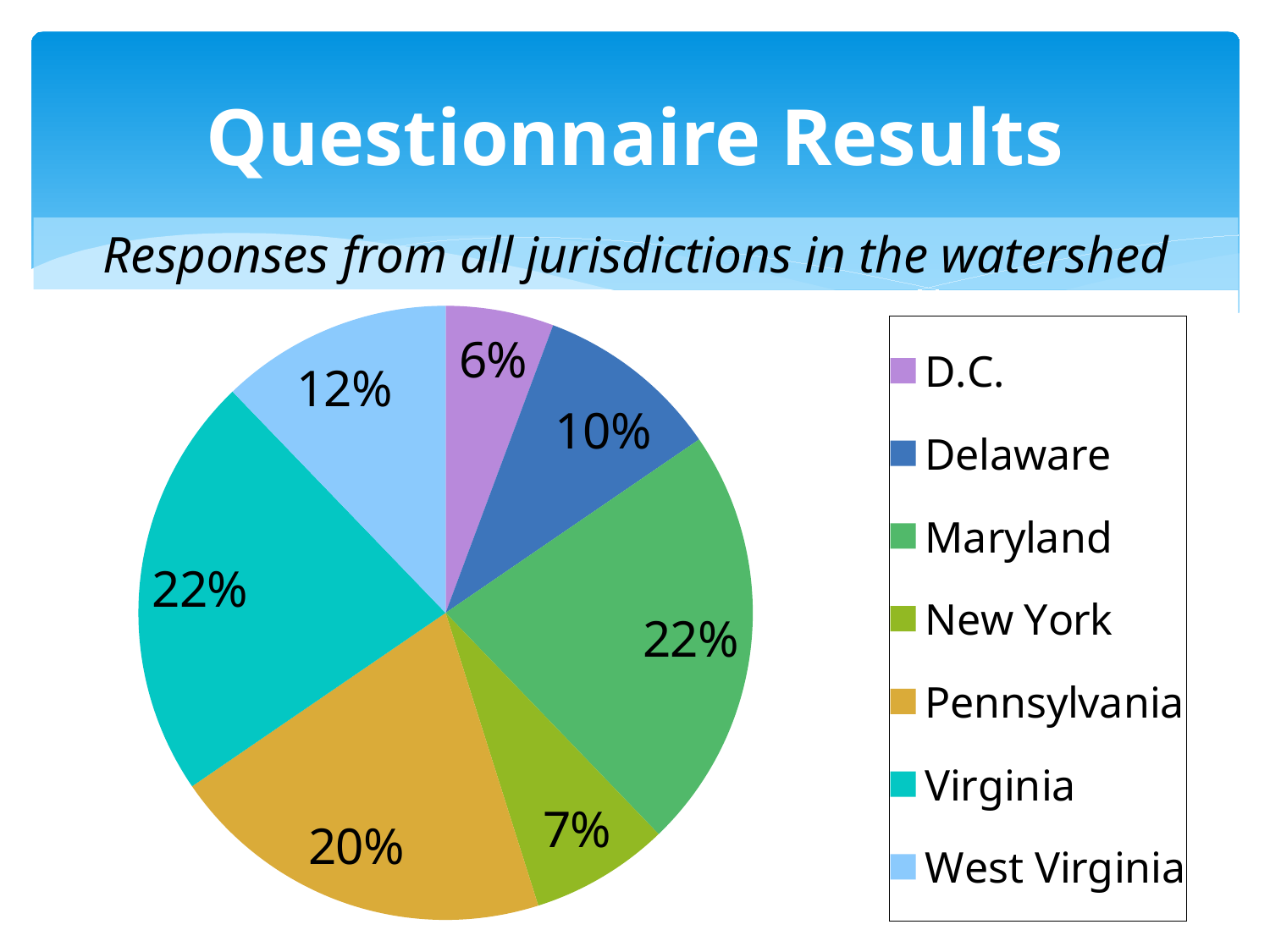
What is the subtitle shown above the pie chart? Responses from all jurisdictions in the watershed What share of responses came from Pennsylvania? 20% What share of responses came from West Virginia? 12% What share of responses came from Maryland? 22% How many jurisdictions are shown in the pie chart? 7 What is the difference in percentage points between West Virginia's share and D.C.'s share? 6 Which has the larger share of responses, Delaware or West Virginia? West Virginia What is the difference in percentage points between Virginia's share and Pennsylvania's share? 2 What kind of chart is shown on the slide? pie chart Which jurisdiction has the smallest share of responses? D.C.